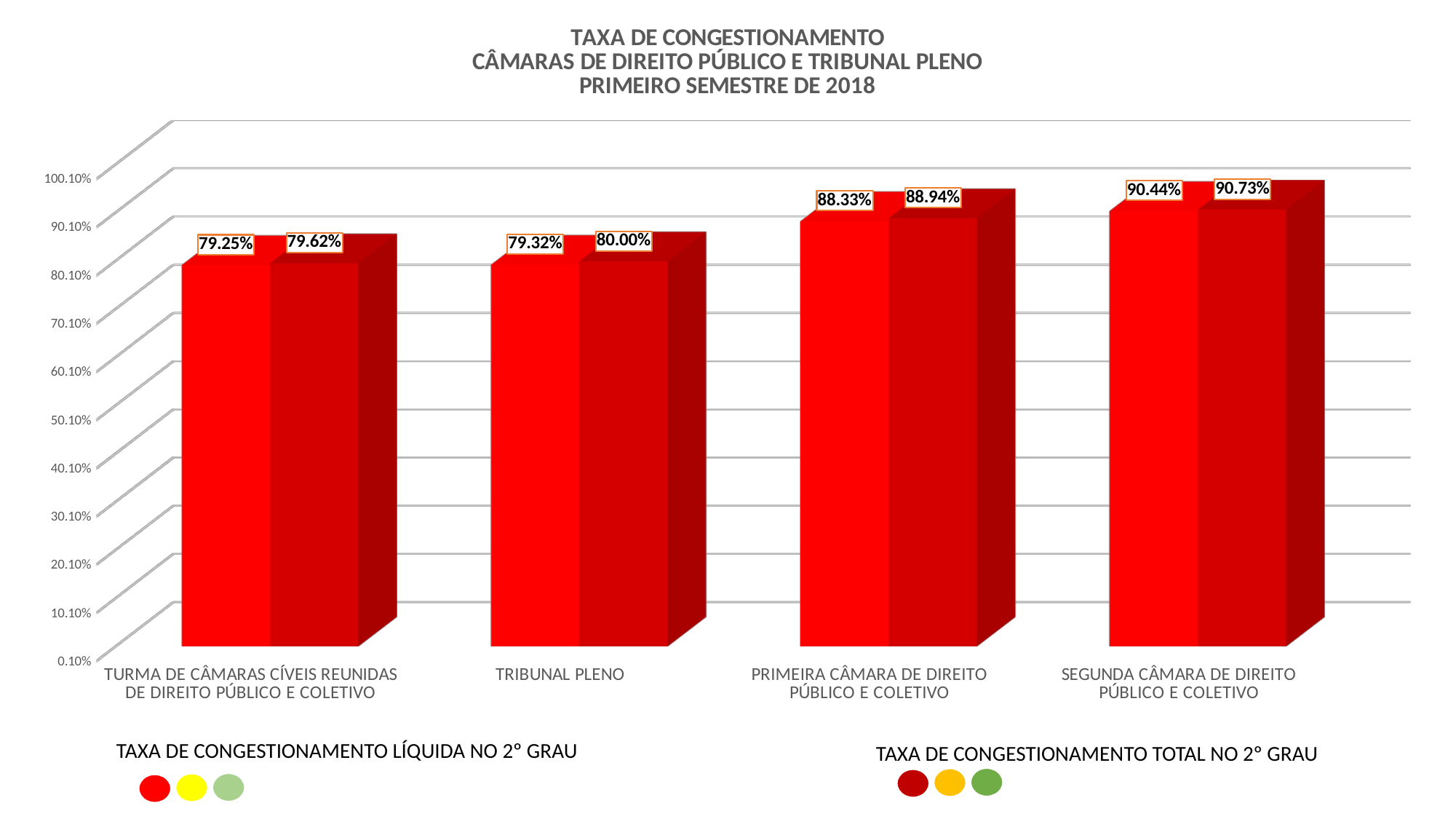
What kind of chart is shown on the slide? Bar chart Which is larger: the taxa de congestionamento líquida for Primeira Câmara de Direito Público e Coletivo or for Tribunal Pleno? Primeira Câmara de Direito Público e Coletivo What is the taxa de congestionamento líquida no 2º grau for Primeira Câmara de Direito Público e Coletivo? 88.33% What is the taxa de congestionamento total no 2º grau for Segunda Câmara de Direito Público e Coletivo? 90.73% Which category has the highest taxa de congestionamento total no 2º grau? Segunda Câmara de Direito Público e Coletivo What is the taxa de congestionamento total no 2º grau for Turma de Câmaras Cíveis Reunidas de Direito Público e Coletivo? 79.62% What is the difference between the taxa de congestionamento total and the taxa de congestionamento líquida for Primeira Câmara de Direito Público e Coletivo? 0.61% How many categories are shown on the x axis of the chart? 4 Which category has the lowest taxa de congestionamento líquida no 2º grau? Turma de Câmaras Cíveis Reunidas de Direito Público e Coletivo What is the difference between the taxa de congestionamento total no 2º grau for Segunda Câmara de Direito Público e Coletivo and for Turma de Câmaras Cíveis Reunidas de Direito Público e Coletivo? 11.11% What is the taxa de congestionamento líquida no 2º grau for Tribunal Pleno? 79.32% How many series does the legend list? 2